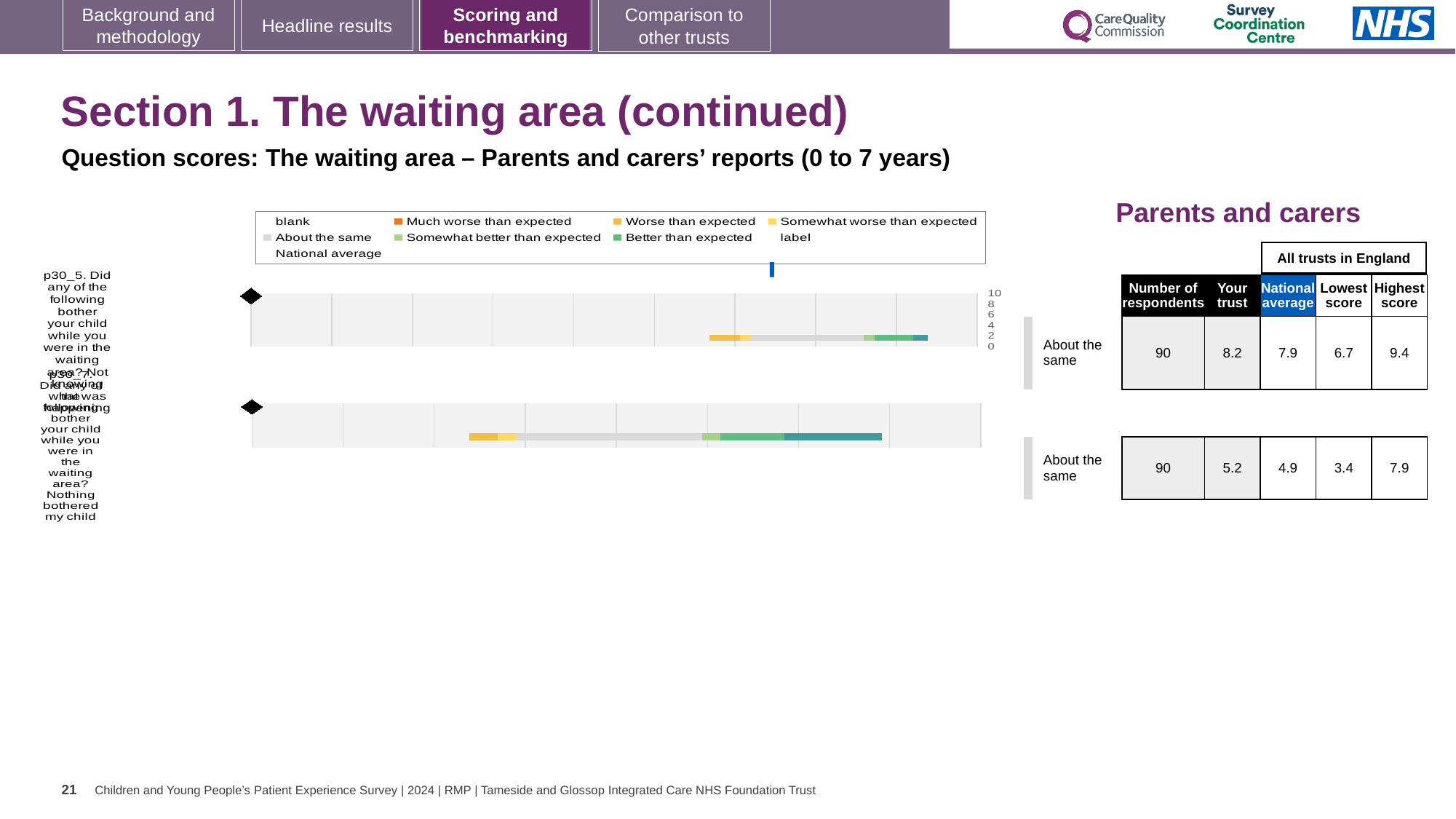
What kind of chart is used to show the question scores on this slide? bar chart According to the table beside the chart, what is the 'Your trust' score for question p30_5 (Did any of the following bother your child while you were in the waiting area? Not knowing what was happening)? 8.2 How many entries does the chart legend list? 9 According to the table beside the chart, what is the 'Your trust' score for question p30_7 (Nothing bothered my child)? 5.2 Which legend entry is shown in grey in the chart? About the same What is the difference between the highest and lowest scores across all trusts in England for question p30_7? 4.5 Which question has the higher 'Your trust' score, p30_5 or p30_7? p30_5 How many respondents answered question p30_7? 90 How many questions (bar rows) are plotted in the chart? 2 What is the highest score across all trusts in England for question p30_5? 9.4 What is the lowest score across all trusts in England for question p30_7? 3.4 What is the national average score for question p30_5 shown in the table? 7.9